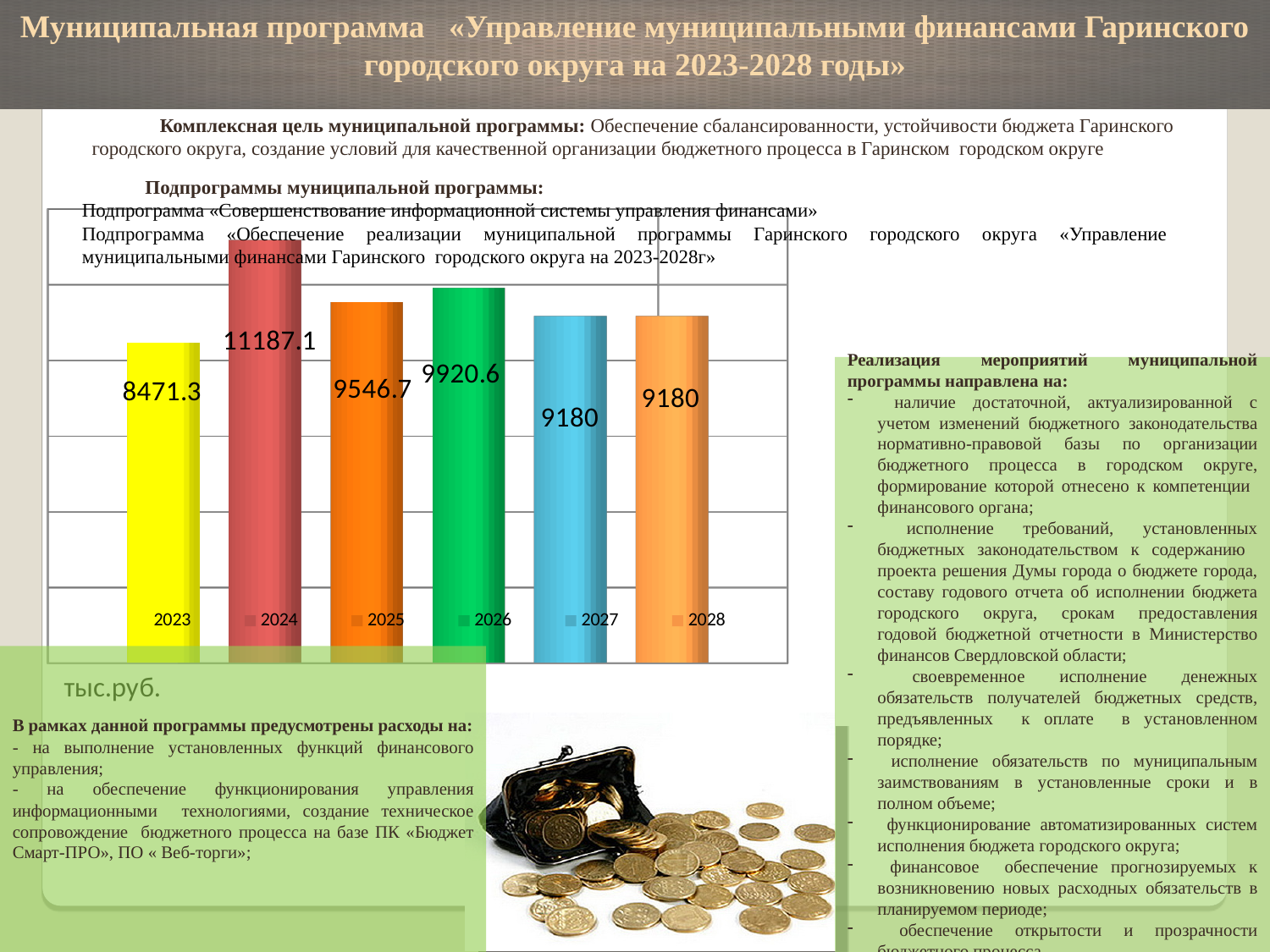
What is the value for 2023 on the bar chart? 8471.3 What is the difference between the values for 2024 and 2023 on the bar chart? 2715.8 Which is larger on the bar chart, the value for 2025 or the value for 2027? 2025 What type of chart is shown on the slide? bar chart What unit is indicated below the bar chart? тыс.руб. How many years are shown on the bar chart? 6 What is the value for 2026 on the bar chart? 9920.6 Which year has the lowest value on the bar chart? 2023 What is the value for 2028 on the bar chart? 9180 Which year has the highest value on the bar chart? 2024 What is the difference between the values for 2026 and 2025 on the bar chart? 373.9 What is the value for 2024 on the bar chart? 11187.1